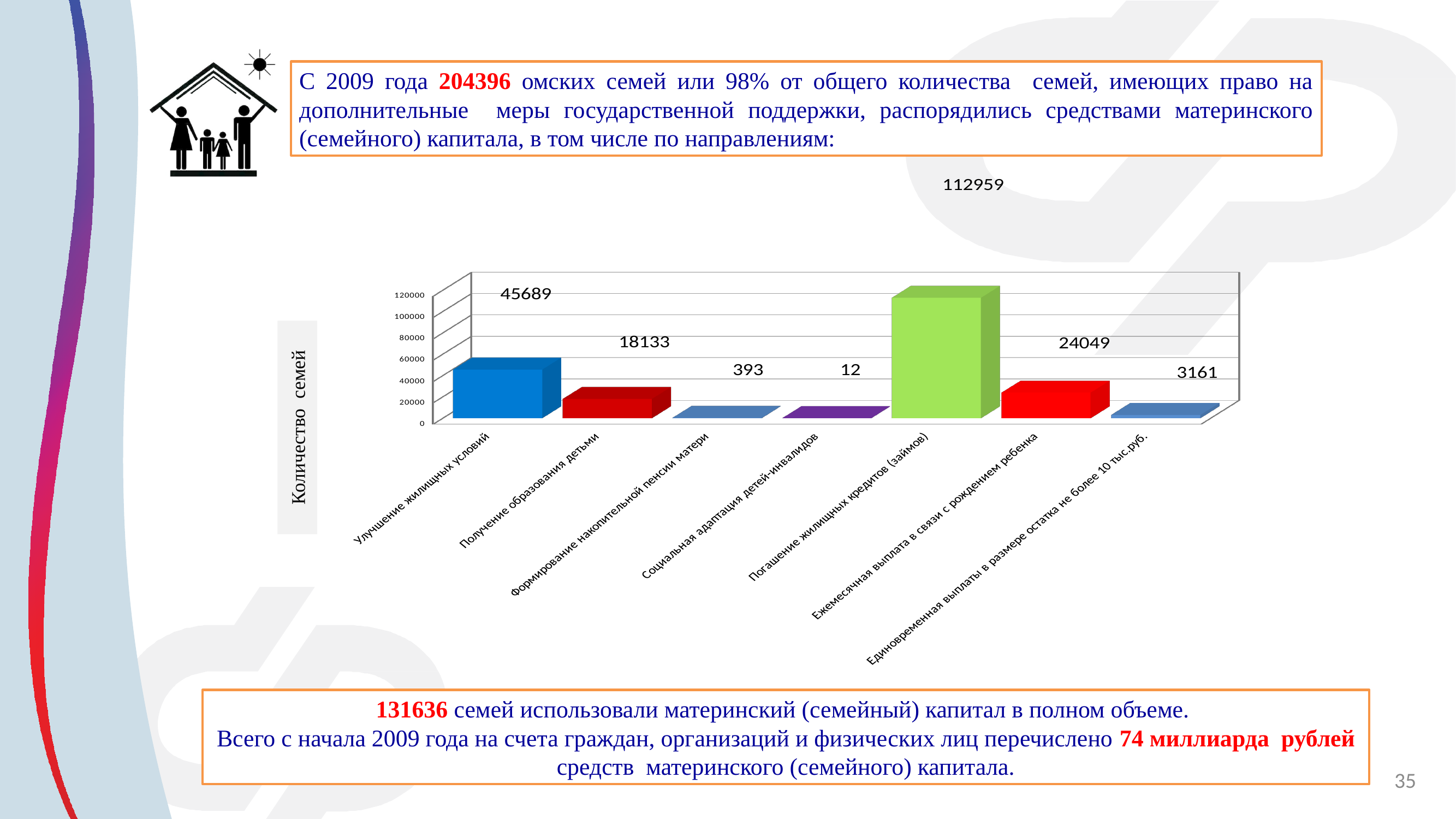
What is the value for Ежемесячная выплата в связи с рождением ребенка? 24049 Which category has the lowest value? Социальная адаптация детей-инвалидов What kind of chart is shown on the slide? bar chart What is the difference between the values for Улучшение жилищных условий and Получение образования детьми? 27556 What is the label on the vertical axis of the chart? Количество семей Is the value for Погашение жилищных кредитов (займов) greater or less than 100000? greater Which is larger: the value for Ежемесячная выплата в связи с рождением ребенка or the value for Получение образования детьми? Ежемесячная выплата в связи с рождением ребенка What is the value for Погашение жилищных кредитов (займов)? 112959 What is the value for Социальная адаптация детей-инвалидов? 12 Which category has the highest value? Погашение жилищных кредитов (займов) How many categories are shown on the chart? 7 What is the value for Улучшение жилищных условий? 45689